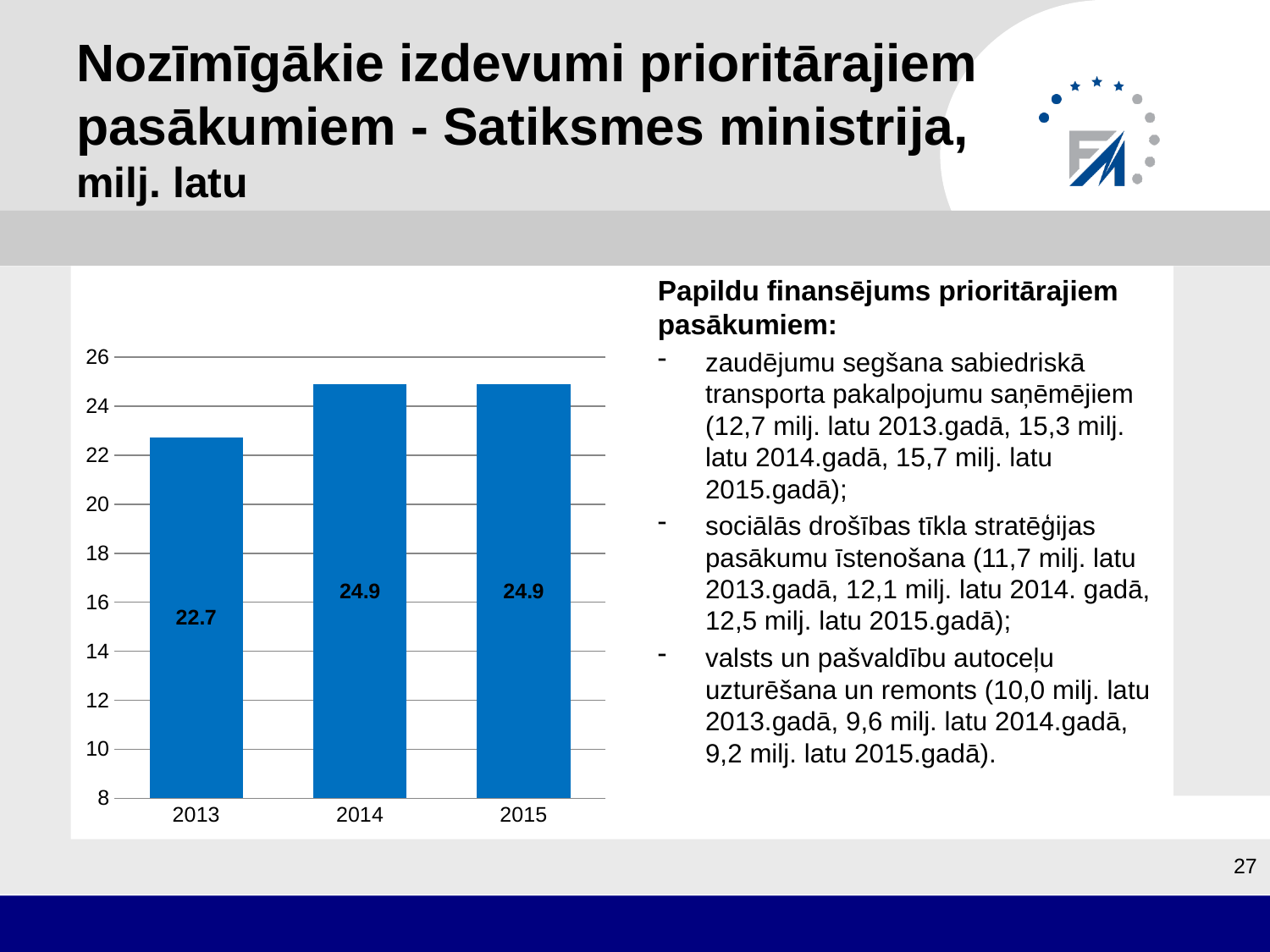
What is the value for 2015? 24.9 What is the lowest value shown on the vertical axis? 8 What is the value for 2014? 24.9 Which is larger, the value for 2013 or the value for 2015? 2015 Is the value for 2013 greater or less than 24? less Does the value rise or fall from 2013 to 2014? rise How many years are shown on the x axis? 3 Which year has the lowest value? 2013 What is the difference between the values for 2014 and 2013? 2.2 Is the value for 2014 greater or less than 24? greater What kind of chart is shown on the slide? bar chart What is the value for 2013? 22.7